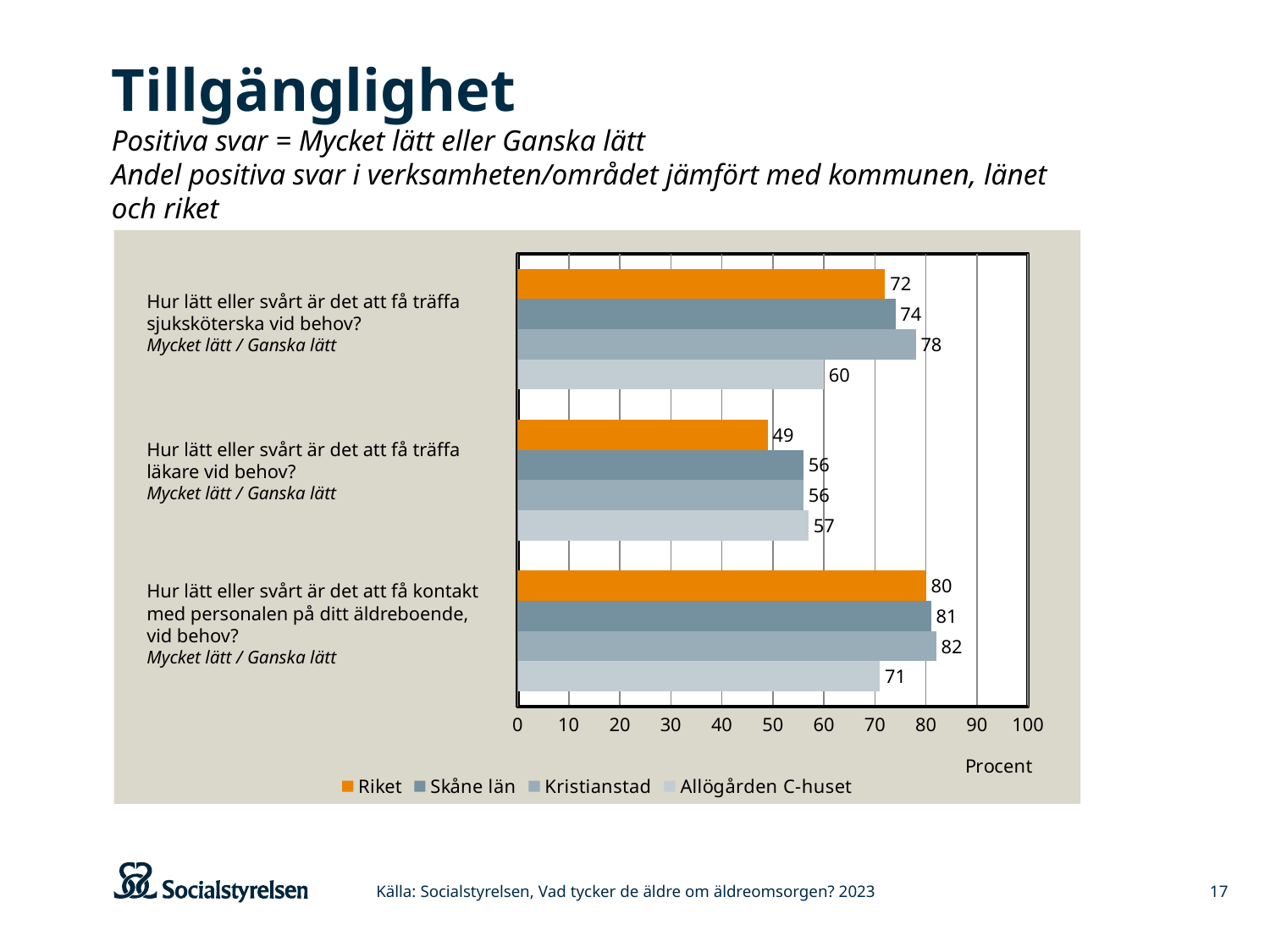
Which is larger for 'Hur lätt eller svårt är det att få kontakt med personalen på ditt äldreboende, vid behov?': Riket or Allögården C-huset? Riket What kind of chart is shown on the slide? Bar chart What unit is shown on the x axis of the chart? Procent What is the value for Allögården C-huset for 'Hur lätt eller svårt är det att få träffa läkare vid behov?'? 57 How many question categories are plotted on the chart? 3 What is the value for Riket for 'Hur lätt eller svårt är det att få träffa sjuksköterska vid behov?'? 72 What is the value for Kristianstad for 'Hur lätt eller svårt är det att få kontakt med personalen på ditt äldreboende, vid behov?'? 82 Which series has the lowest value for 'Hur lätt eller svårt är det att få träffa läkare vid behov?'? Riket Is the value for Riket for 'Hur lätt eller svårt är det att få träffa läkare vid behov?' greater or less than 50? less What is the difference between Kristianstad and Allögården C-huset for 'Hur lätt eller svårt är det att få träffa sjuksköterska vid behov?'? 18 Which series has the highest value for 'Hur lätt eller svårt är det att få träffa sjuksköterska vid behov?'? Kristianstad How many series does the legend list? 4